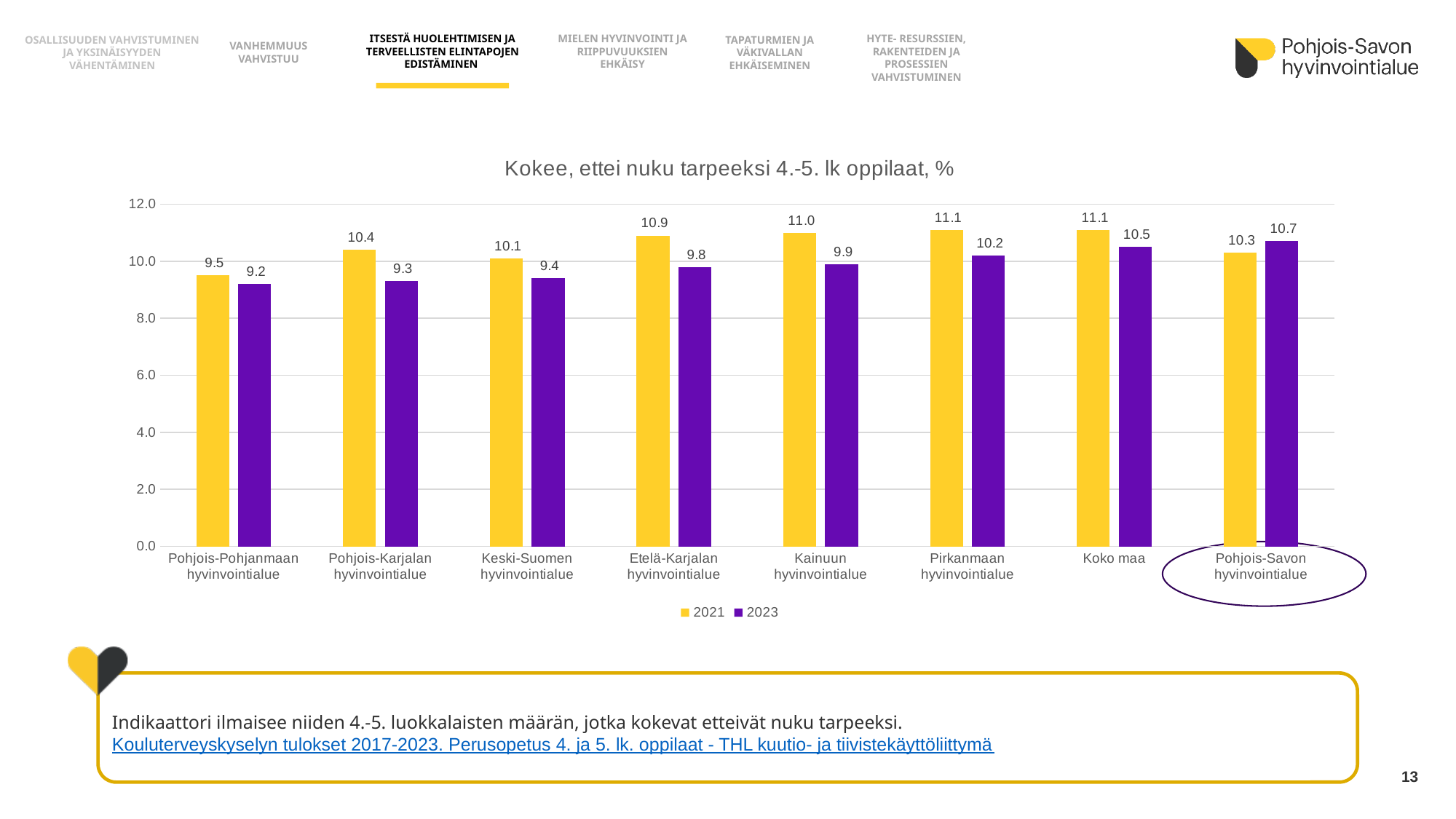
For Pohjois-Savon hyvinvointialue, which is larger: the 2021 value or the 2023 value? 2023 Which category has the highest 2023 value? Pohjois-Savon hyvinvointialue Which category has the lowest 2021 value? Pohjois-Pohjanmaan hyvinvointialue How many series does the legend list? 2 What type of chart is shown on the slide? Bar chart What is the 2021 value for Etelä-Karjalan hyvinvointialue? 10.9 Which category has the lowest 2023 value? Pohjois-Pohjanmaan hyvinvointialue What is the 2023 value for Koko maa? 10.5 What is the difference between the 2021 and 2023 values for Pirkanmaan hyvinvointialue? 0.9 Is the 2023 value for Kainuun hyvinvointialue greater or less than 10.0? less What is the 2023 value for Pohjois-Savon hyvinvointialue? 10.7 How many categories are shown on the x axis? 8